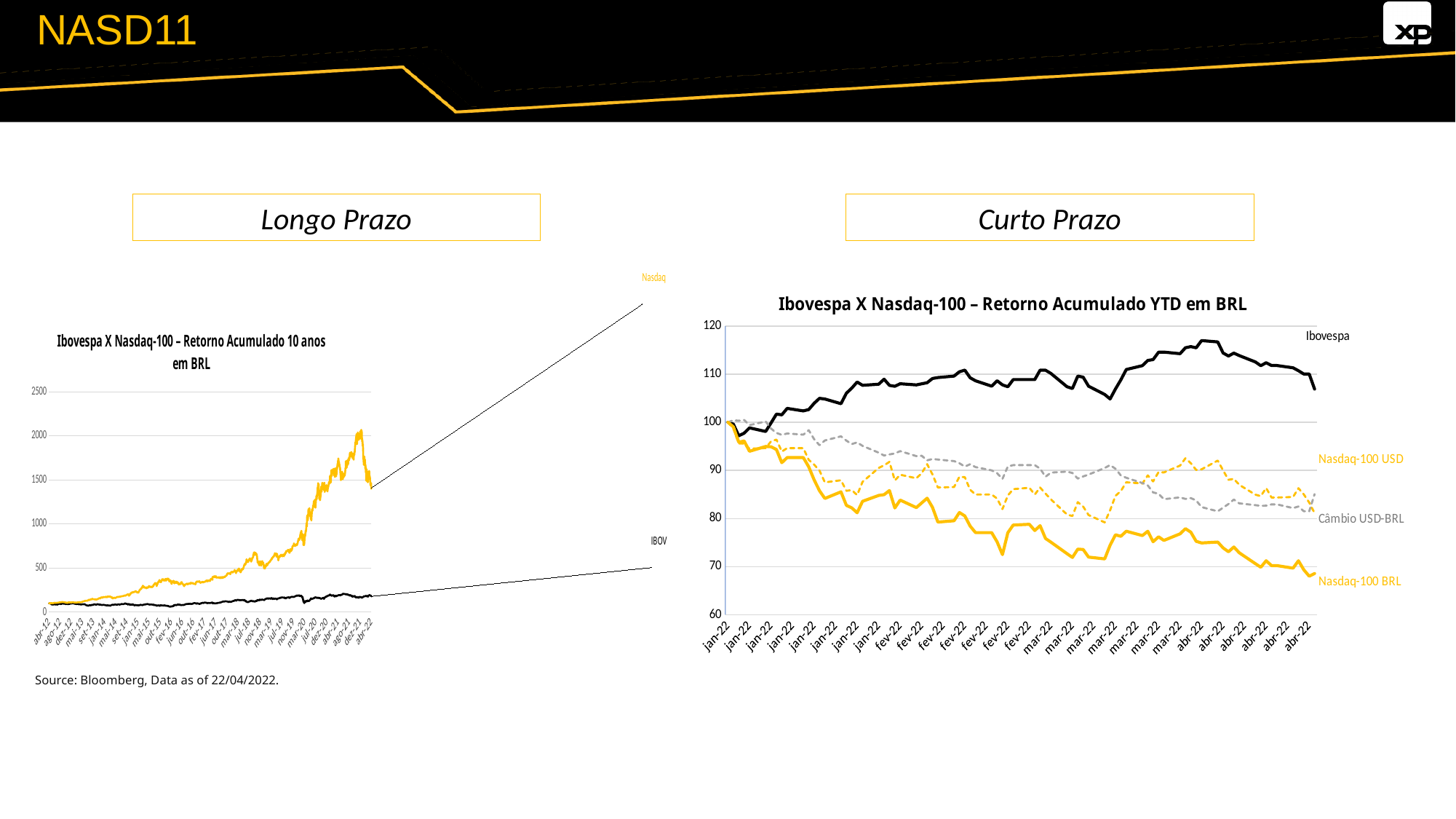
On the right chart, which series has the highest value at the end of the period (abr-22)? Ibovespa On the right chart, is the peak value of Ibovespa greater or less than 110? greater On the right chart, is the final value of Nasdaq-100 BRL greater or less than 70? less How many series are plotted on the 'Retorno Acumulado 10 anos em BRL' chart on the left? 2 What kind of chart is the 'Ibovespa X Nasdaq-100 – Retorno Acumulado 10 anos em BRL' chart on the left? Line chart On the left chart, which series reaches a higher value over the 10-year period, Nasdaq or IBOV? Nasdaq On the left chart, is the peak value of the Nasdaq series greater or less than 1500? greater On the right chart, does the Nasdaq-100 BRL series generally rise or fall from jan-22 to abr-22? Fall On the right chart, which series has the lowest value at the end of the period (abr-22)? Nasdaq-100 BRL What kind of chart is the 'Ibovespa X Nasdaq-100 – Retorno Acumulado YTD em BRL' chart on the right? Line chart How many series are plotted on the 'Retorno Acumulado YTD em BRL' chart on the right? 4